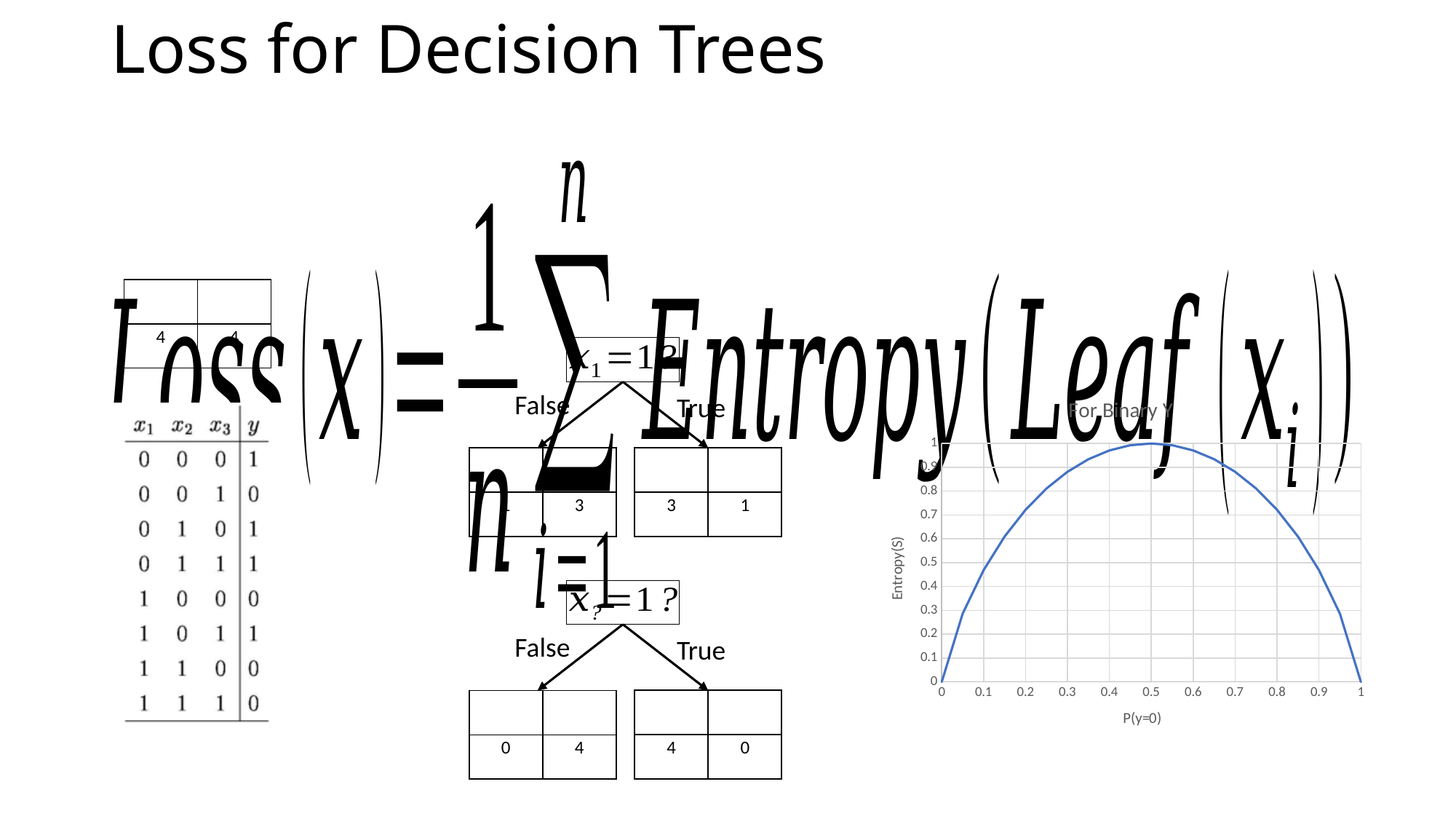
What kind of chart is shown on the right side of the slide? line chart In the entropy chart, is the value of Entropy(S) at P(y=0) = 0.9 greater or less than 0.6? less In the entropy chart, what is the value of Entropy(S) when P(y=0) is 0? 0 In the entropy chart, does Entropy(S) rise or fall as P(y=0) increases from 0.5 to 1? fall In the entropy chart, at which value of P(y=0) does the curve reach its highest point? 0.5 In the entropy chart, is the value of Entropy(S) at P(y=0) = 0.2 greater or less than 0.6? greater In the entropy chart, which is larger: Entropy(S) at P(y=0) = 0.4 or at P(y=0) = 0.1? P(y=0) = 0.4 What is the label of the x axis of the entropy chart? P(y=0) In the entropy chart, what is the value of Entropy(S) when P(y=0) is 0.5? 1 What is the label of the y axis of the entropy chart? Entropy(S) In the entropy chart, is the value of Entropy(S) at P(y=0) = 0.1 greater or less than 0.4? greater In the entropy chart, what is the value of Entropy(S) when P(y=0) is 1? 0